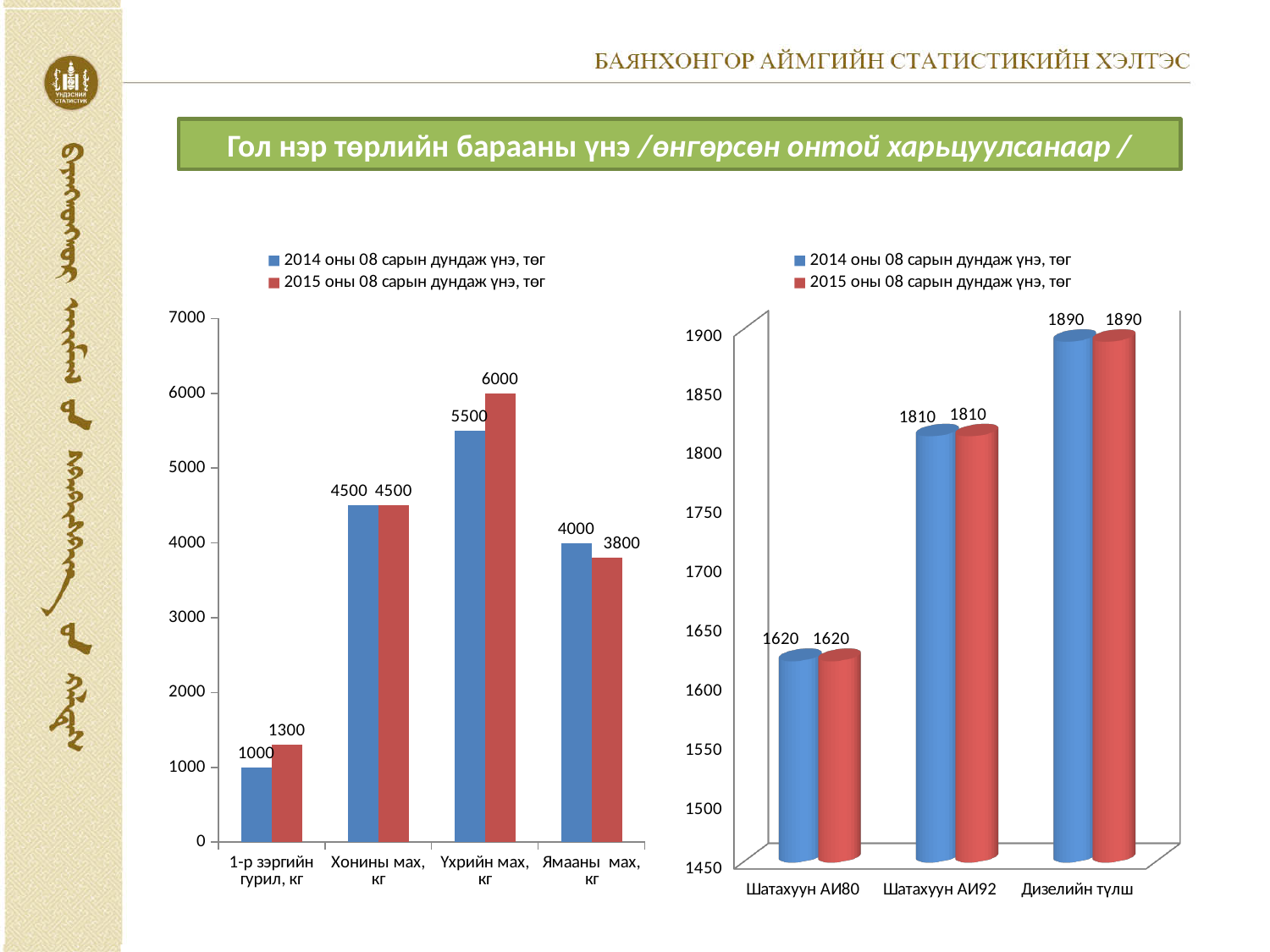
On the left chart, what is the 2014 оны 08 сарын дундаж үнэ for 1-р зэргийн гурил, кг? 1000 How many series does the legend of the right chart list? 2 On the left chart, what is the difference between the 2015 and 2014 values for Ямааны мах, кг? 200 On the right chart, what is the 2014 оны 08 сарын дундаж үнэ for Шатахуун АИ92? 1810 On the left chart, what is the 2015 оны 08 сарын дундаж үнэ for Үхрийн мах, кг? 6000 On the right chart, what is the difference between the 2015 values for Дизелийн түлш and Шатахуун АИ80? 270 On the left chart, which category has the lowest 2014 оны 08 сарын дундаж үнэ? 1-р зэргийн гурил, кг How many categories are shown on the left chart? 4 What kind of chart is the right chart? Bar chart On the left chart, which category has the highest 2015 оны 08 сарын дундаж үнэ? Үхрийн мах, кг On the right chart, which category has the highest 2015 оны 08 сарын дундаж үнэ? Дизелийн түлш On the left chart, which is larger for 1-р зэргийн гурил, кг: the 2014 value or the 2015 value? 2015 value